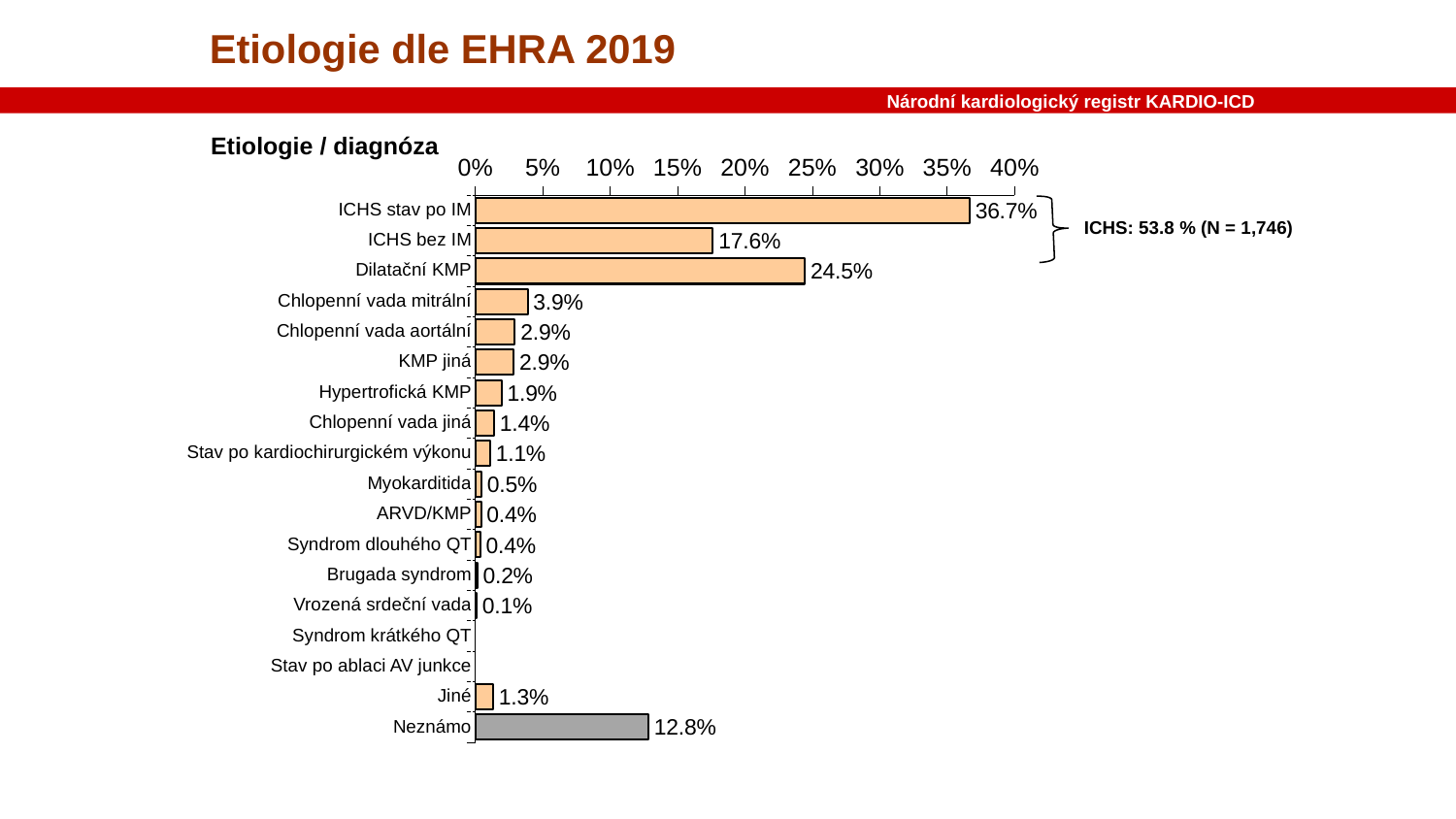
What is the value for ICHS stav po IM? 36.7% Which is larger, the value for Dilatační KMP or the value for ICHS bez IM? Dilatační KMP What is the difference between the values for ICHS stav po IM and ICHS bez IM? 19.1% What is the value for Neznámo? 12.8% What combined ICHS share does the annotation next to the chart state? 53.8 % (N = 1,746) How many categories are listed on the chart? 18 Which category has the highest value? ICHS stav po IM What kind of chart is shown on the slide? bar chart What is the title of the chart? Etiologie / diagnóza What is the value for Dilatační KMP? 24.5% Is the value for ICHS stav po IM greater or less than 35%? greater What is the value for Hypertrofická KMP? 1.9%